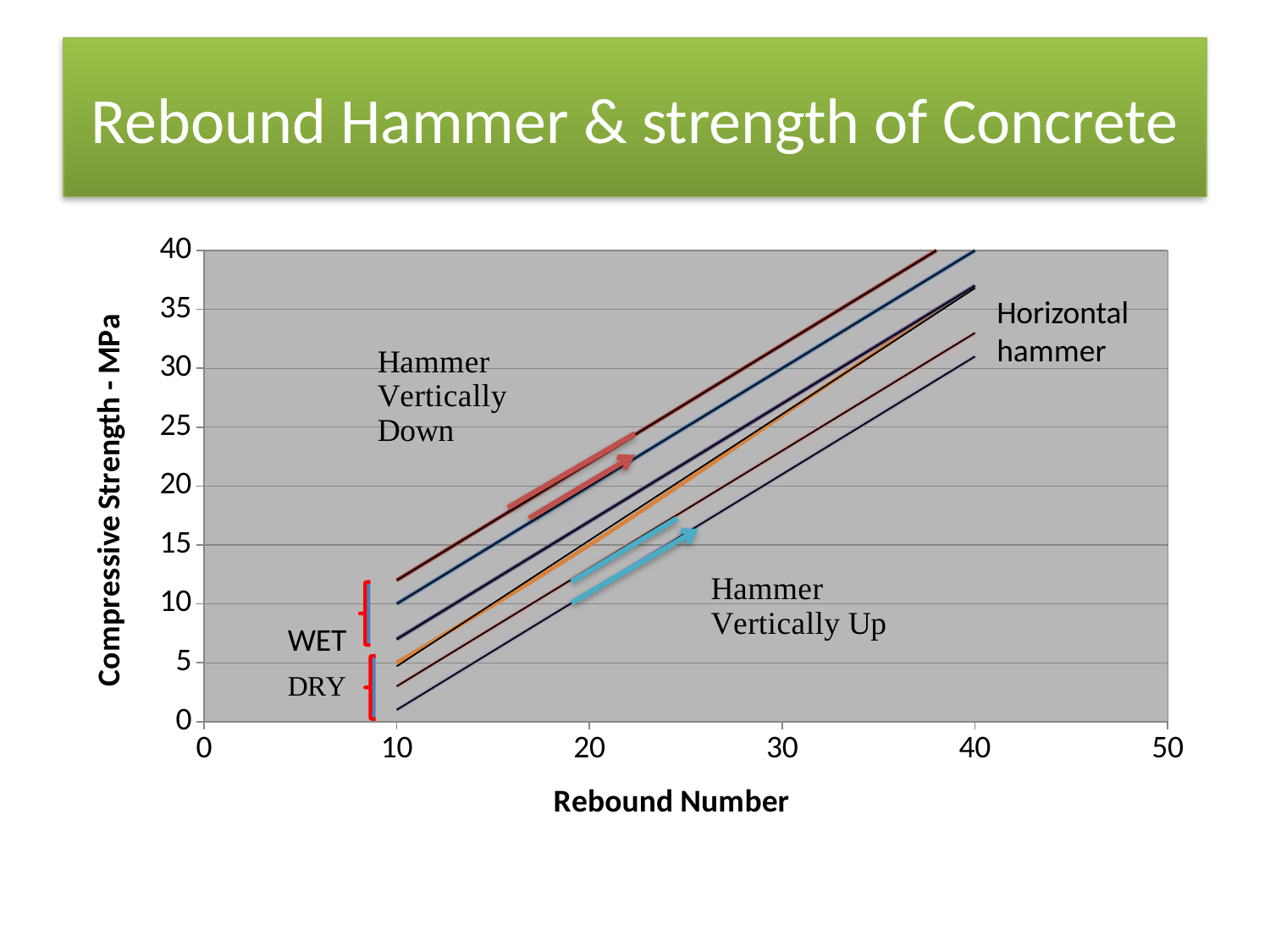
At a rebound number of 10, is the value of the topmost line greater or less than 10? greater Do the lines rise or fall as the rebound number increases? rise At a rebound number of 10, is the value of the lowest line greater or less than 5? less At a rebound number of 30, is the value of the topmost line greater or less than 25? greater What is the title of the x axis? Rebound Number What is the title of the y axis? Compressive Strength - MPa What kind of chart is shown on the slide? line chart How many lines are plotted on the chart? 6